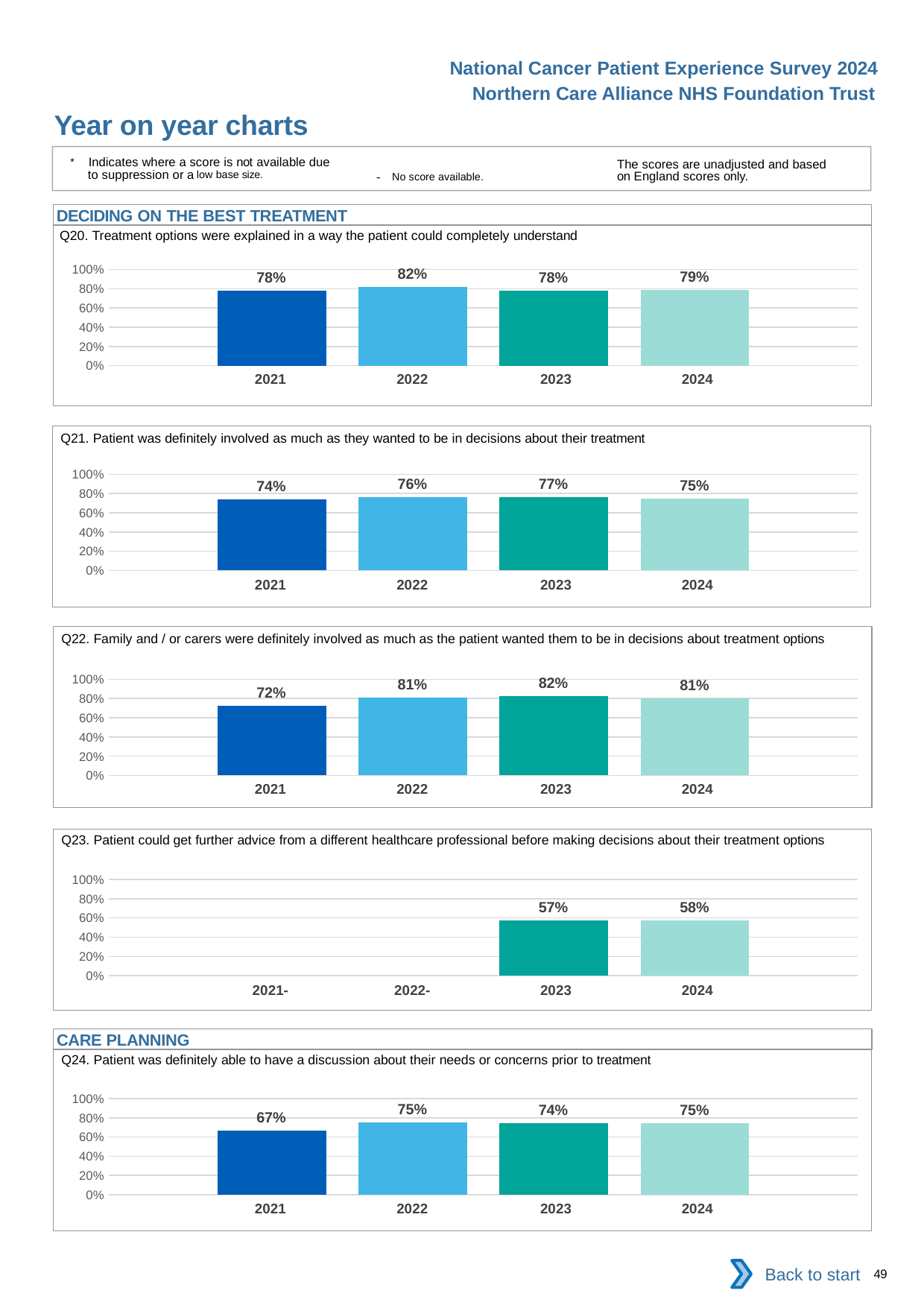
In the Q24 chart, which year has the lowest value? 2021 In the Q20 chart, what is the value for 2022? 82% What kind of chart is the Q21 chart? bar chart In the Q24 chart, is the value for 2022 larger or smaller than the value for 2023? larger In the Q20 chart, what is the difference between the 2024 value and the 2023 value? 1% In the Q22 chart, what is the difference between the 2022 value and the 2021 value? 9% In the Q22 chart, is the value for 2021 greater or less than 60%? greater In the Q21 chart, what is the value for 2024? 75% In the Q23 chart, what is the value for 2024? 58% Which section heading appears above the Q24 chart? CARE PLANNING In the Q23 chart, how many years have a bar plotted? 2 In the Q21 chart, which year has the highest value? 2023